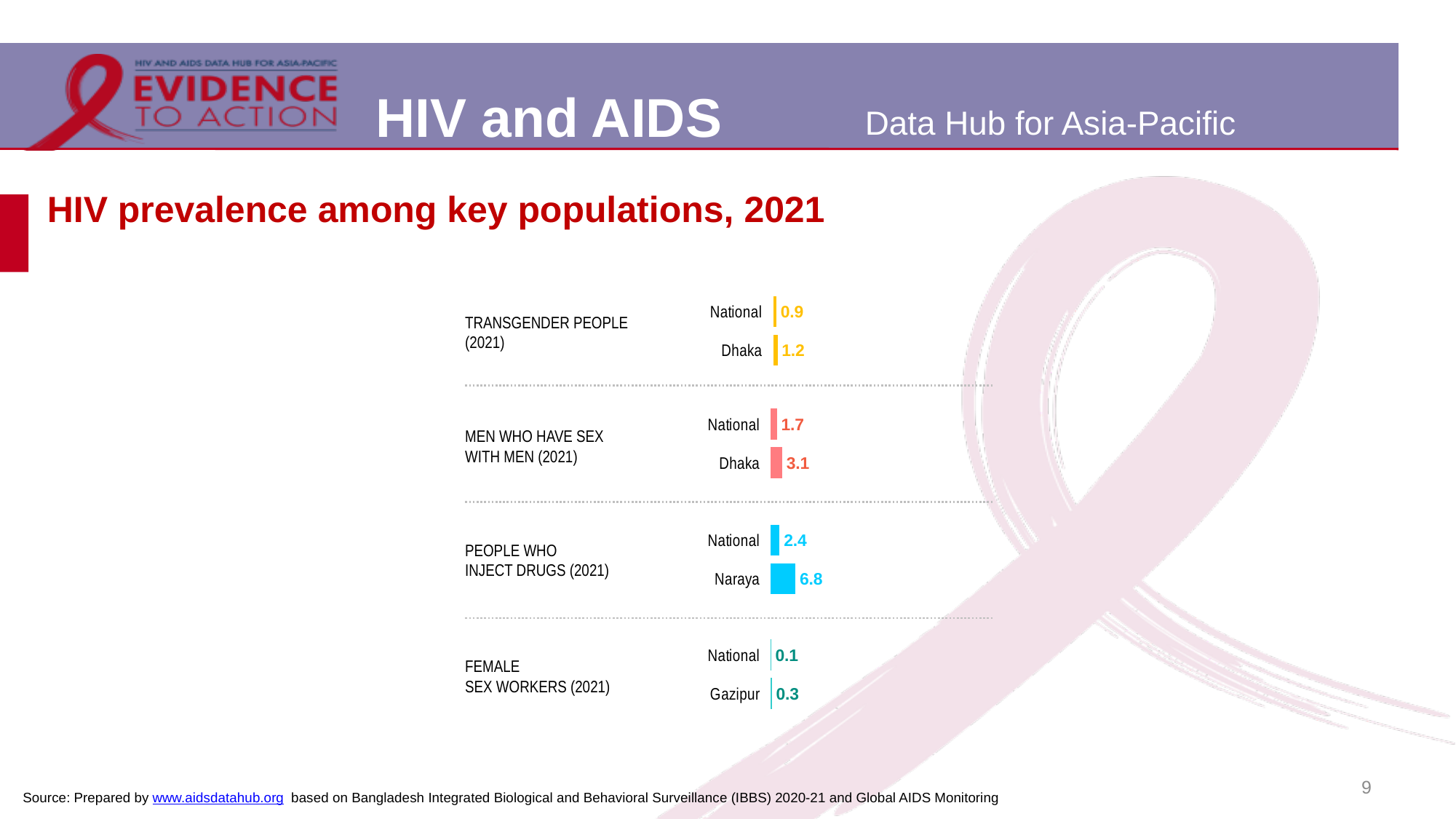
Which bar shows the highest HIV prevalence on the slide? People who inject drugs, Naraya What kind of chart is used to show HIV prevalence among key populations? Bar chart What is the HIV prevalence among transgender people at the national level? 0.9 Which bar shows the lowest HIV prevalence on the slide? Female sex workers, National What is the national HIV prevalence among female sex workers? 0.1 What is the difference between the Naraya and national HIV prevalence among people who inject drugs? 4.4 What is the HIV prevalence among men who have sex with men in Dhaka? 3.1 What is the HIV prevalence among people who inject drugs in Naraya? 6.8 Which is larger: the national HIV prevalence among men who have sex with men or among people who inject drugs? People who inject drugs What is the title of the chart on the slide? HIV prevalence among key populations, 2021 How many key population groups are shown in the chart? 4 What is the difference between the Dhaka and national HIV prevalence among men who have sex with men? 1.4